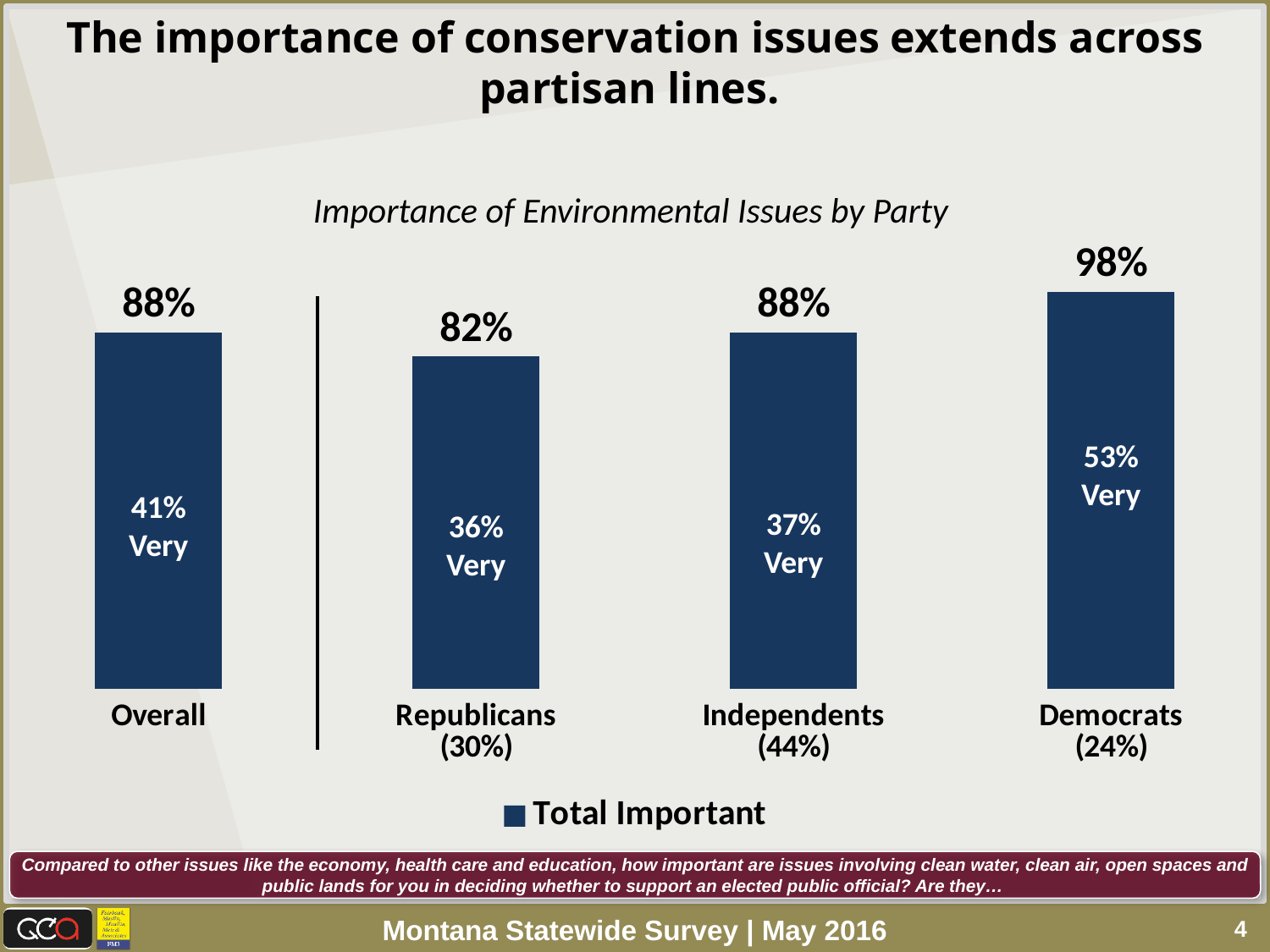
What is the difference between the Total Important values for Democrats and Republicans? 16 percentage points What is the title of the chart? Importance of Environmental Issues by Party How many series does the legend list? 1 How many groups are shown on the chart? 4 What percentage of Independents say the issues are Very important? 37% What is the Total Important value for Republicans? 82% What kind of chart is shown on the slide? Bar chart Which group has the lowest Total Important value? Republicans What is the Total Important value for Democrats? 98% Which is larger, the Very important share for Democrats or for Republicans? Democrats Which group has the highest Total Important value? Democrats What percentage of the Overall group say the issues are Very important? 41%